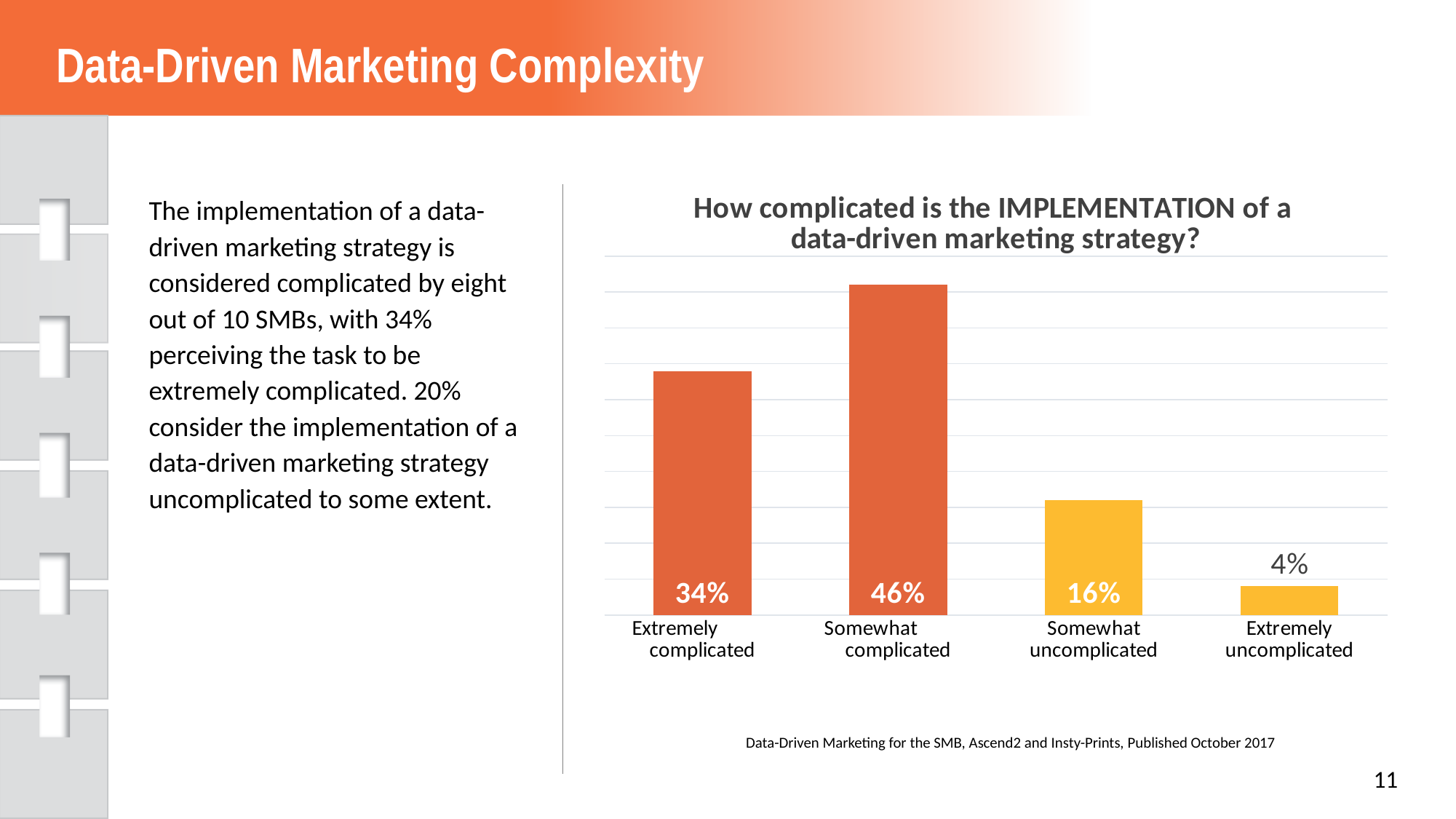
What percentage of respondents said the implementation is extremely complicated? 34% What is the difference between Somewhat complicated and Extremely complicated? 12% What is the difference between Somewhat uncomplicated and Extremely uncomplicated? 12% What is the value for Somewhat uncomplicated? 16% How many categories are shown in the chart? 4 Which is larger, Extremely complicated or Somewhat uncomplicated? Extremely complicated What is the value for Extremely uncomplicated? 4% Which category has the lowest value? Extremely uncomplicated What is the title of the chart? How complicated is the IMPLEMENTATION of a data-driven marketing strategy? What is the value for Somewhat complicated? 46% What type of chart is shown on the slide? Bar chart Which category has the highest value? Somewhat complicated